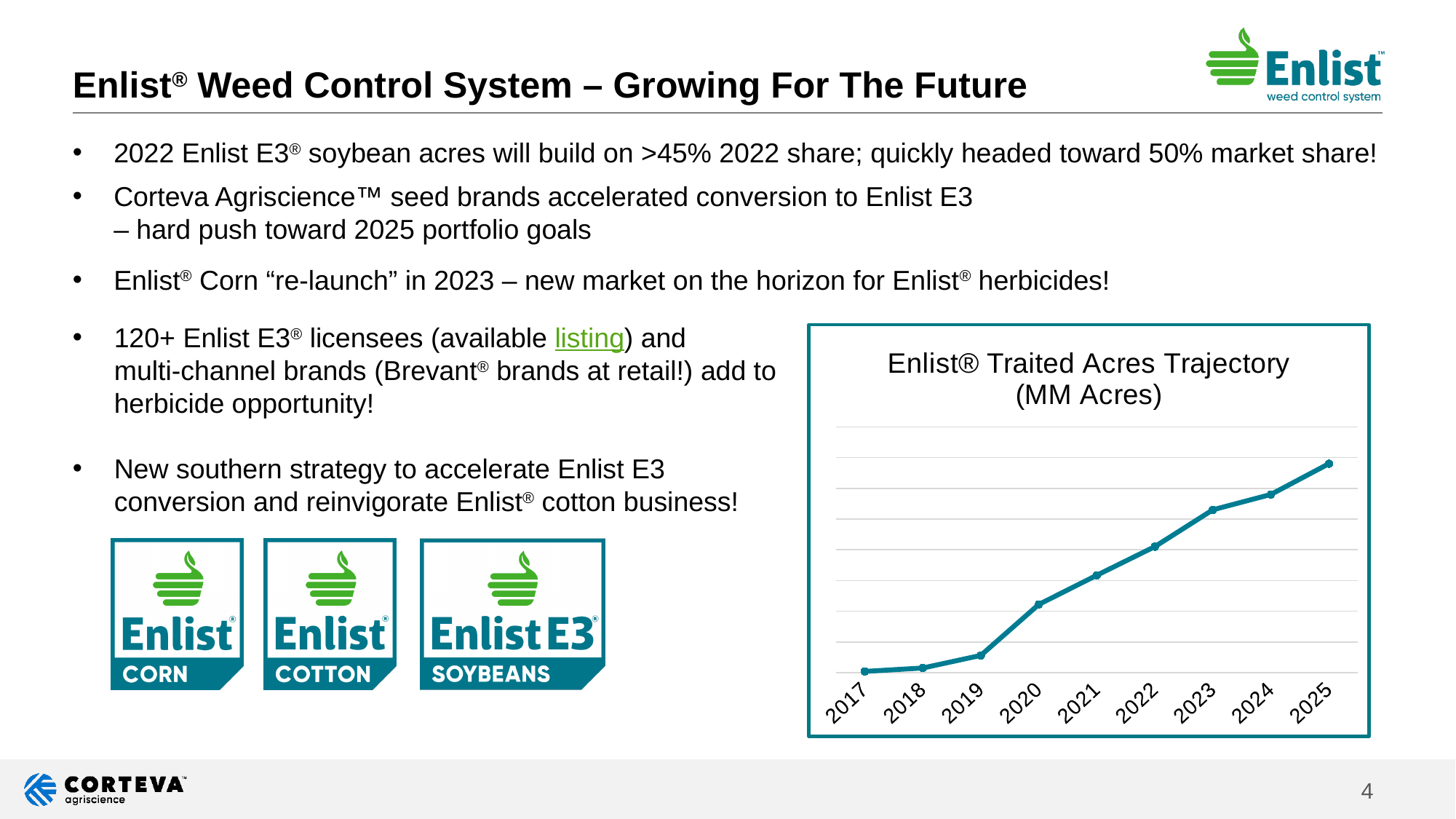
What is the title of the chart? Enlist® Traited Acres Trajectory (MM Acres) Do the values in the chart rise or fall from 2017 to 2025? rise Which year has the larger value, 2020 or 2023? 2023 Which year has the larger value, 2019 or 2018? 2019 Which year has the highest value in the chart? 2025 How many years are plotted on the x axis of the chart? 9 Which year has the larger value, 2022 or 2024? 2024 Which year has the lowest value in the chart? 2017 What is the first year shown on the x axis of the chart? 2017 What kind of chart is shown on the slide? line chart